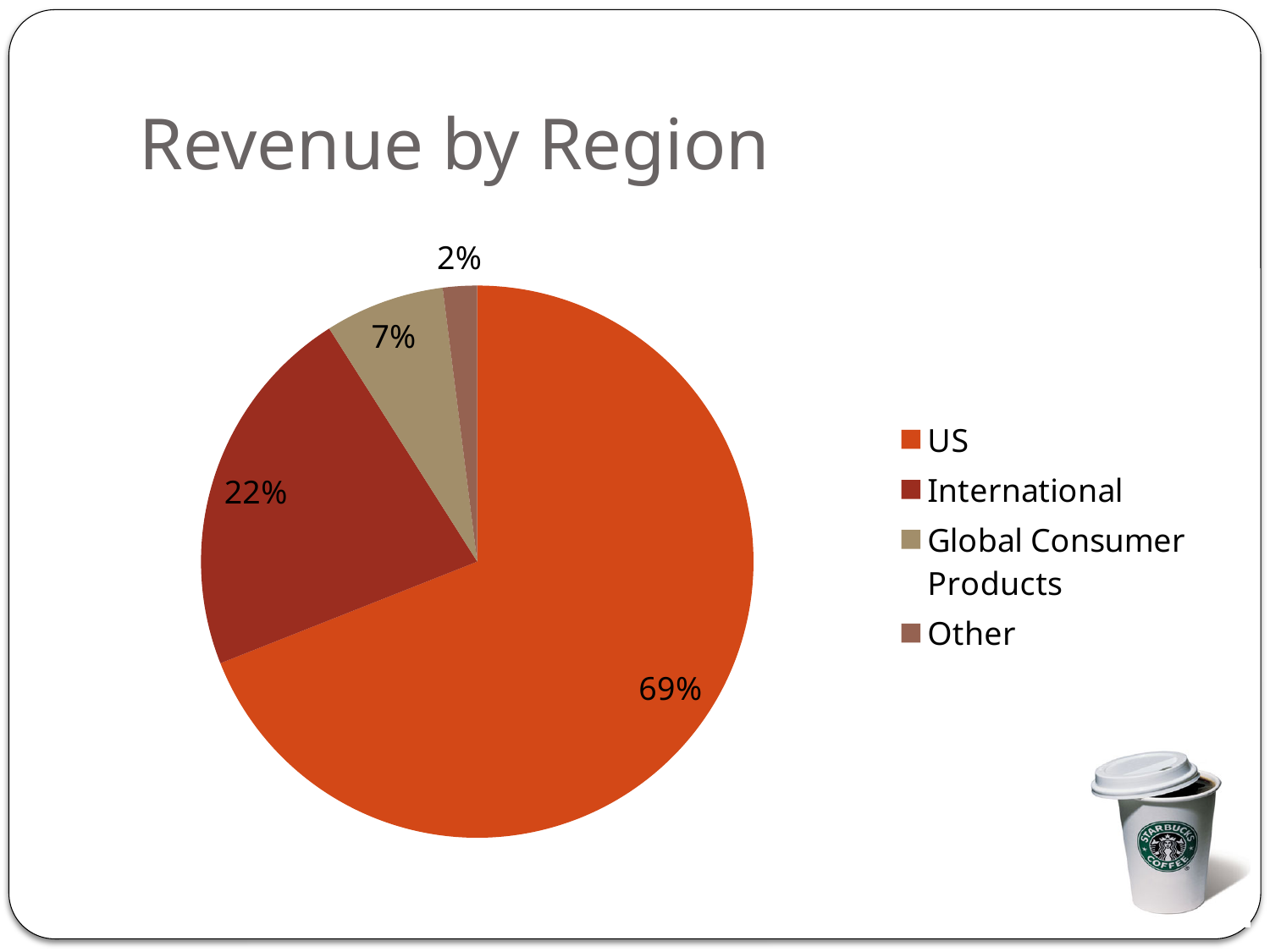
Which region has the smallest share of revenue? Other What share of revenue comes from Other? 2% What share of revenue comes from the US? 69% How many slices does the pie chart have? 4 How many entries does the legend list? 4 What kind of chart is shown on the slide? pie chart Which region has the largest share of revenue? US What share of revenue comes from International? 22% What is the title of the chart? Revenue by Region How many percentage points larger is the US share than the International share? 47 Which has a larger share of revenue, International or Global Consumer Products? International What share of revenue comes from Global Consumer Products? 7%